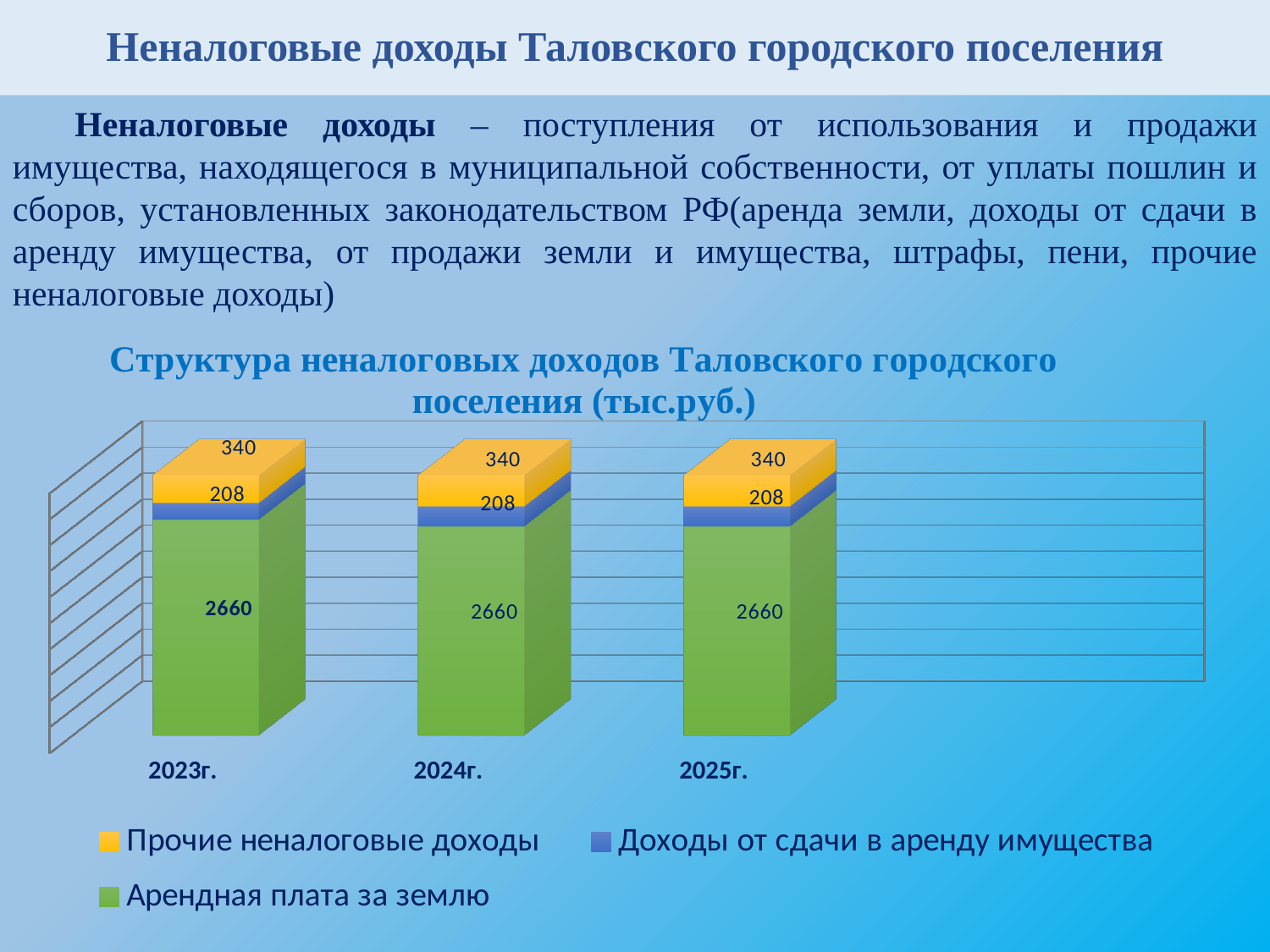
What is the value for Арендная плата за землю in 2023г.? 2660 What is the total of the stacked bar for 2024г.? 3208 Which series has the largest value in 2024г.? Арендная плата за землю How many series does the legend list? 3 What is the value for Доходы от сдачи в аренду имущества in 2024г.? 208 Does the value for Арендная плата за землю rise, fall or stay the same from 2023г. to 2025г.? Stays the same What kind of chart is shown on the slide? Stacked bar chart How many years (categories) are shown on the x axis? 3 What is the value for Прочие неналоговые доходы in 2025г.? 340 What is the difference between Арендная плата за землю and Прочие неналоговые доходы in 2025г.? 2320 Which is larger in 2023г.: Прочие неналоговые доходы or Доходы от сдачи в аренду имущества? Прочие неналоговые доходы Which series has the smallest value in 2023г.? Доходы от сдачи в аренду имущества